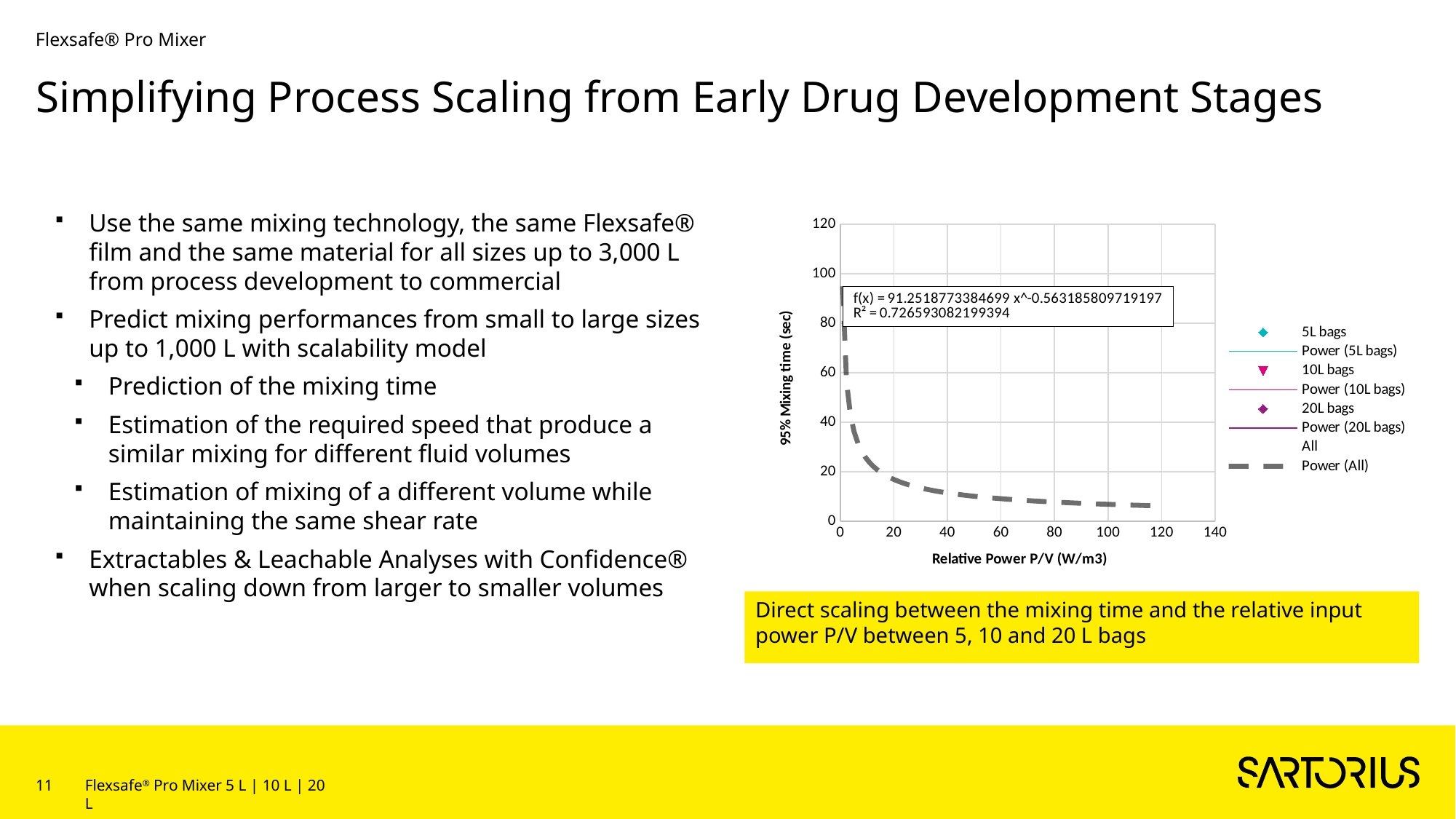
Is the value of the dashed Power (All) trendline at a relative power of 100 W/m3 greater or less than 20 sec? less What is the maximum value shown on the x axis of the chart? 140 What is the label of the y axis of the chart? 95% Mixing time (sec) What is the R² value shown for the trendline on the chart? 0.726593082199394 Is the value of the dashed Power (All) trendline at a relative power of 40 W/m3 greater or less than 40 sec? less What kind of chart is shown on the slide? scatter chart with a trendline Does the dashed Power (All) trendline rise or fall as relative power increases along the x axis? fall What is the label of the x axis of the chart? Relative Power P/V (W/m3) How many entries does the chart legend list? 8 Which legend entry is drawn as a thick grey dashed line? Power (All) What is the trendline equation f(x) shown on the chart? f(x) = 91.2518773384699 x^-0.563185809719197 What is the maximum value shown on the y axis of the chart? 120